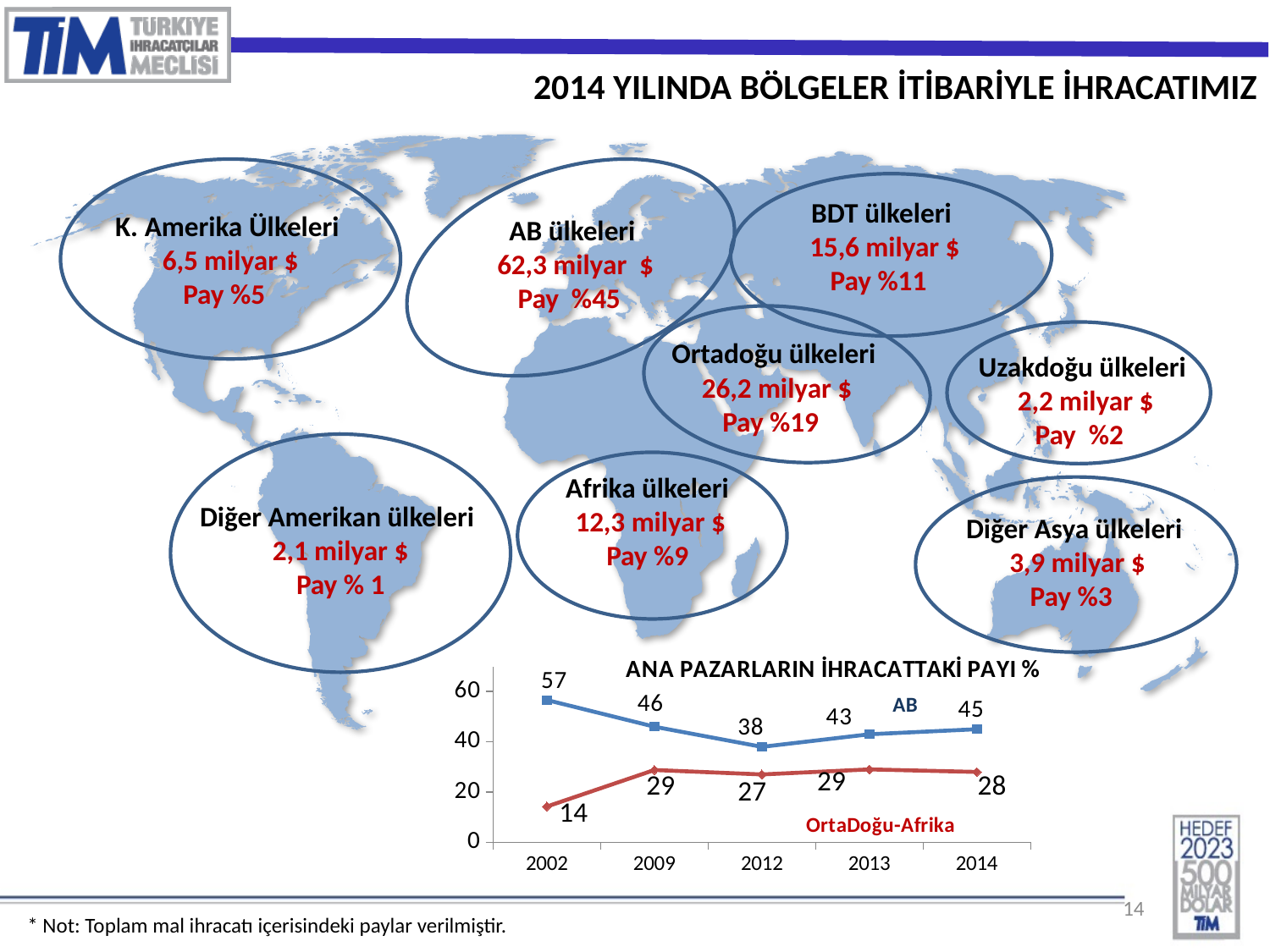
In which year is the AB series highest in the chart titled "ANA PAZARLARIN İHRACATTAKİ PAYI %"? 2002 What is the value for AB in 2012 in the chart titled "ANA PAZARLARIN İHRACATTAKİ PAYI %"? 38 What kind of chart is the chart titled "ANA PAZARLARIN İHRACATTAKİ PAYI %"? Line chart In which year is the OrtaDoğu-Afrika series lowest in the chart titled "ANA PAZARLARIN İHRACATTAKİ PAYI %"? 2002 What is the difference between the AB value and the OrtaDoğu-Afrika value in 2014 in the chart titled "ANA PAZARLARIN İHRACATTAKİ PAYI %"? 17 In the chart titled "ANA PAZARLARIN İHRACATTAKİ PAYI %", is the AB value in 2009 greater or less than 40? greater How many series are plotted in the chart titled "ANA PAZARLARIN İHRACATTAKİ PAYI %"? 2 What is the value for AB in 2002 in the chart titled "ANA PAZARLARIN İHRACATTAKİ PAYI %"? 57 What is the value for OrtaDoğu-Afrika in 2014 in the chart titled "ANA PAZARLARIN İHRACATTAKİ PAYI %"? 28 How many years are shown on the x axis of the chart titled "ANA PAZARLARIN İHRACATTAKİ PAYI %"? 5 In the chart titled "ANA PAZARLARIN İHRACATTAKİ PAYI %", does the AB series rise or fall from 2002 to 2012? Fall In the chart titled "ANA PAZARLARIN İHRACATTAKİ PAYI %", which series has the larger value in 2012, AB or OrtaDoğu-Afrika? AB